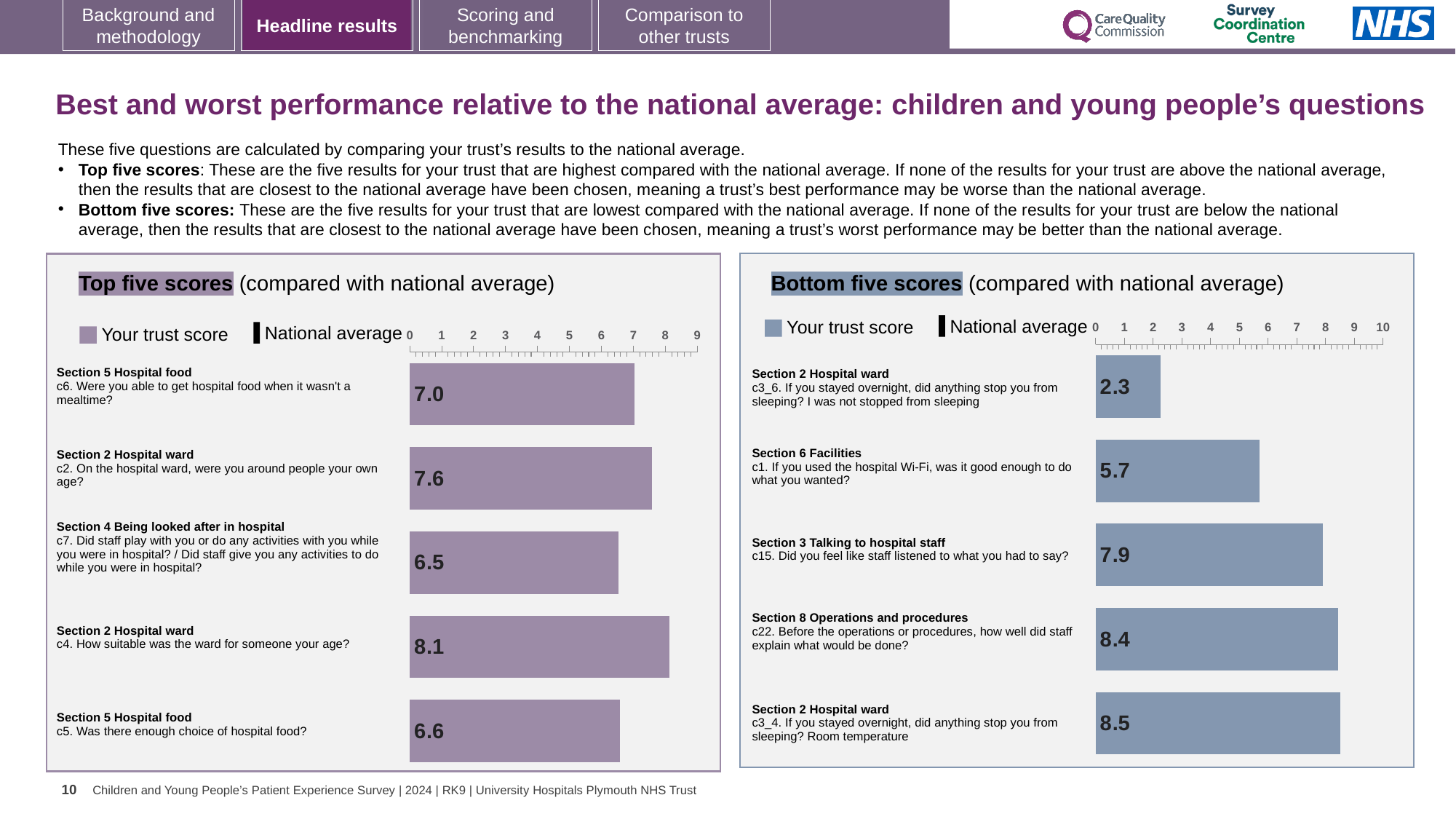
In the Top five scores chart, what is the trust score for c6 'Were you able to get hospital food when it wasn't a mealtime?' 7.0 In the Bottom five scores chart, what is the difference between the scores for c3_4 and c3_6? 6.2 In the Top five scores chart, which question has the highest trust score? c4. How suitable was the ward for someone your age? In the Top five scores chart, which has the larger score: c5 'Was there enough choice of hospital food?' or c6 'Were you able to get hospital food when it wasn't a mealtime?' c6. Were you able to get hospital food when it wasn't a mealtime? How many series does the legend of the Bottom five scores chart list? 2 In the Top five scores chart, what is the difference between the scores for c2 (7.6) and c7 (6.5)? 1.1 In the Bottom five scores chart, what is the trust score for c1 about the hospital Wi-Fi? 5.7 In the Top five scores chart, what is the trust score for c4 'How suitable was the ward for someone your age?' 8.1 In the Bottom five scores chart, which question has the lowest trust score? c3_6. If you stayed overnight, did anything stop you from sleeping? I was not stopped from sleeping How many questions are shown in the Bottom five scores chart? 5 In the Bottom five scores chart, what is the trust score for c22 'Before the operations or procedures, how well did staff explain what would be done?' 8.4 What kind of chart is the Top five scores chart? Bar chart